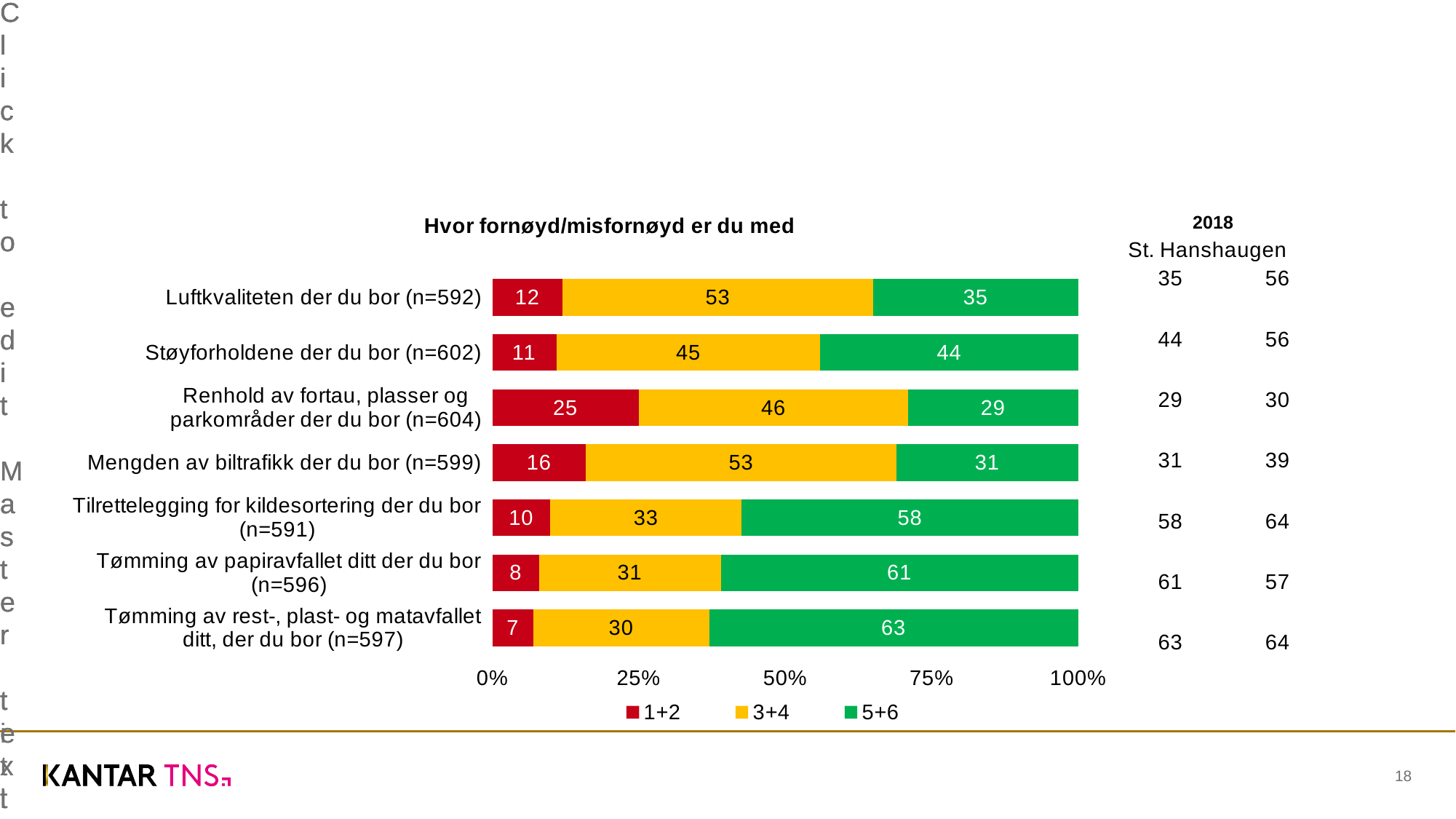
What is the value of the 3+4 series for "Støyforholdene der du bor (n=602)"? 45 Which category has the lowest value for the 1+2 series? Tømming av rest-, plast- og matavfallet ditt, der du bor (n=597) Which category has the highest value for the 5+6 series? Tømming av rest-, plast- og matavfallet ditt, der du bor (n=597) What is the value of the 1+2 series for "Renhold av fortau, plasser og parkområder der du bor (n=604)"? 25 How many categories are shown in the chart? 7 What is the difference between the 5+6 values for "Tilrettelegging for kildesortering der du bor (n=591)" and "Mengden av biltrafikk der du bor (n=599)"? 27 What is the title of the chart? Hvor fornøyd/misfornøyd er du med How many series does the legend list? 3 What kind of chart is shown on the slide? Stacked bar chart What is the value of the 5+6 series for "Luftkvaliteten der du bor (n=592)"? 35 What is the total of the stacked bar for "Tømming av papiravfallet ditt der du bor (n=596)"? 100 Which is larger: the 1+2 value for "Mengden av biltrafikk der du bor (n=599)" or the 1+2 value for "Luftkvaliteten der du bor (n=592)"? Mengden av biltrafikk der du bor (n=599)